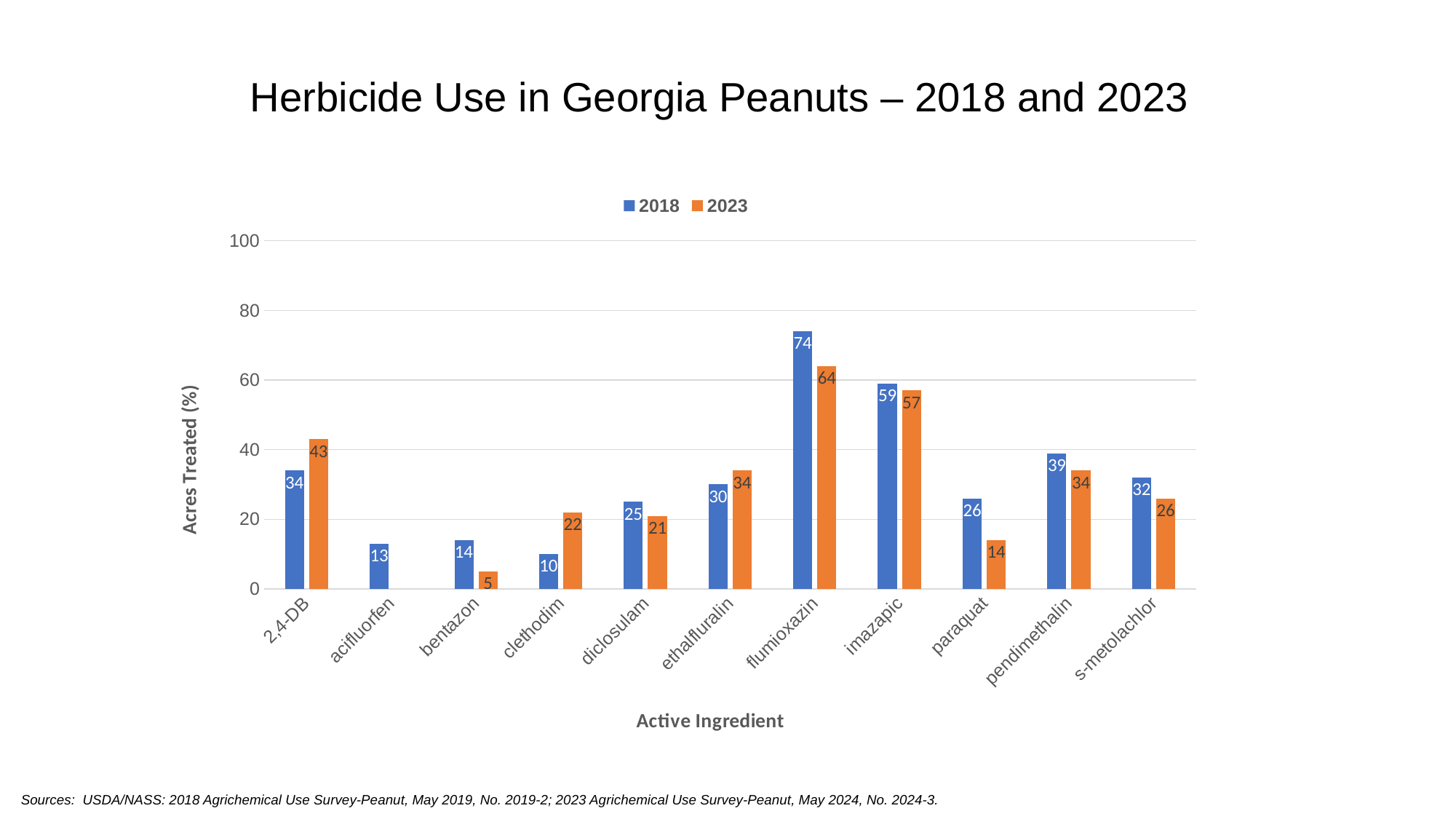
What is the 2023 value for paraquat? 14 What is the difference between the 2018 and 2023 values for paraquat? 12 How many series does the legend list? 2 What kind of chart is shown on the slide? bar chart What is the 2018 value for flumioxazin? 74 Which is larger for clethodim, the 2018 value or the 2023 value? 2023 Which active ingredient has the lowest 2023 value? bentazon Which active ingredient has the highest 2018 value? flumioxazin What is the 2023 value for 2,4-DB? 43 Is the 2018 value for imazapic greater or less than 40? greater How many active ingredients are shown on the x axis? 11 What is the label of the y axis? Acres Treated (%)